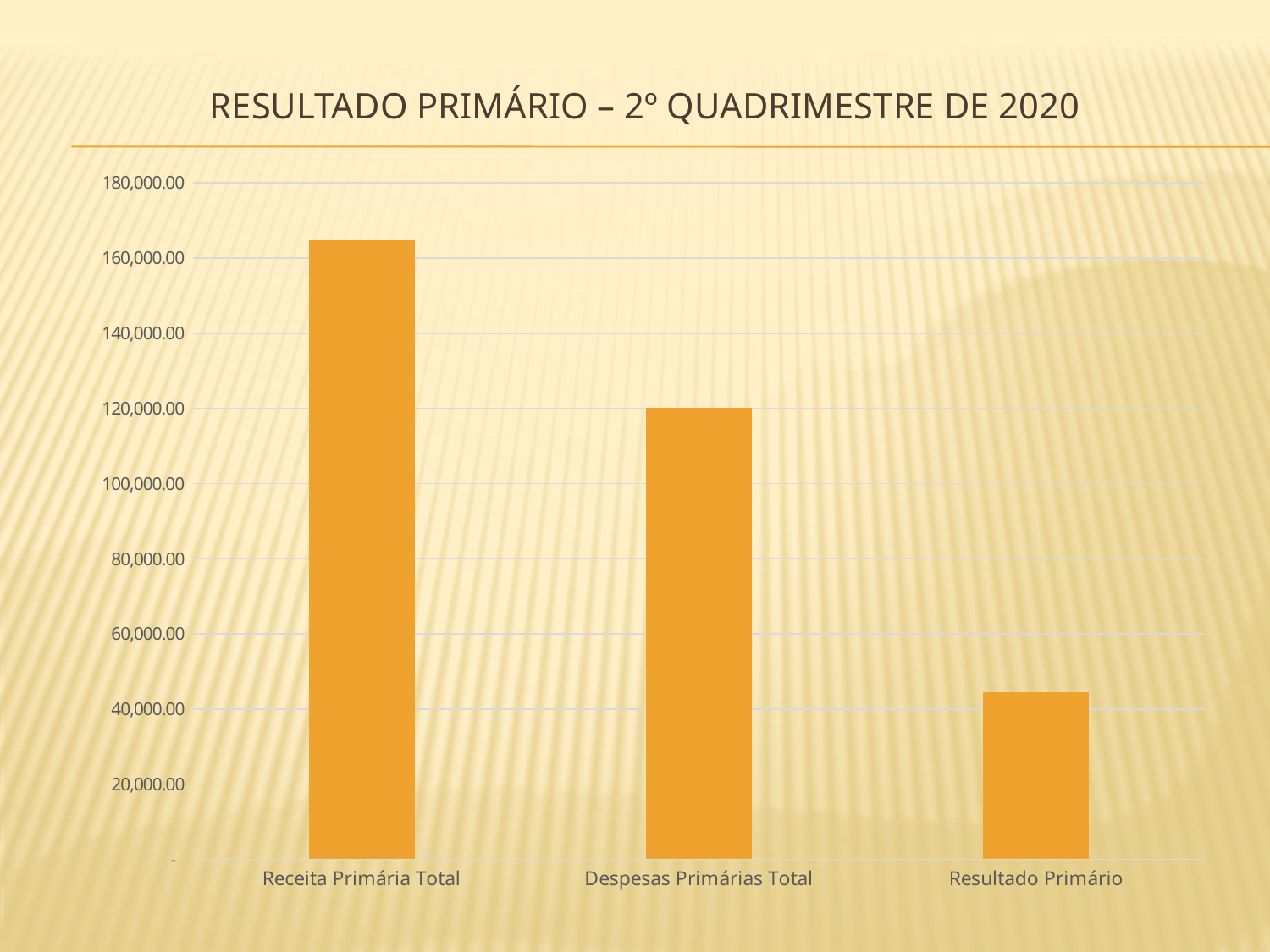
Which category has the highest bar? Receita Primária Total Is the value for Receita Primária Total greater or less than 160,000.00? greater What is the highest value shown on the y axis? 180,000.00 Which is larger, Receita Primária Total or Despesas Primárias Total? Receita Primária Total Which category has the lowest bar? Resultado Primário What is the title of the chart? RESULTADO PRIMÁRIO – 2º QUADRIMESTRE DE 2020 Is the value for Resultado Primário greater or less than 40,000.00? greater How many categories are shown on the x axis of the chart? 3 What kind of chart is shown on the slide? bar chart Is the value for Resultado Primário greater or less than 60,000.00? less Which is larger, Despesas Primárias Total or Resultado Primário? Despesas Primárias Total